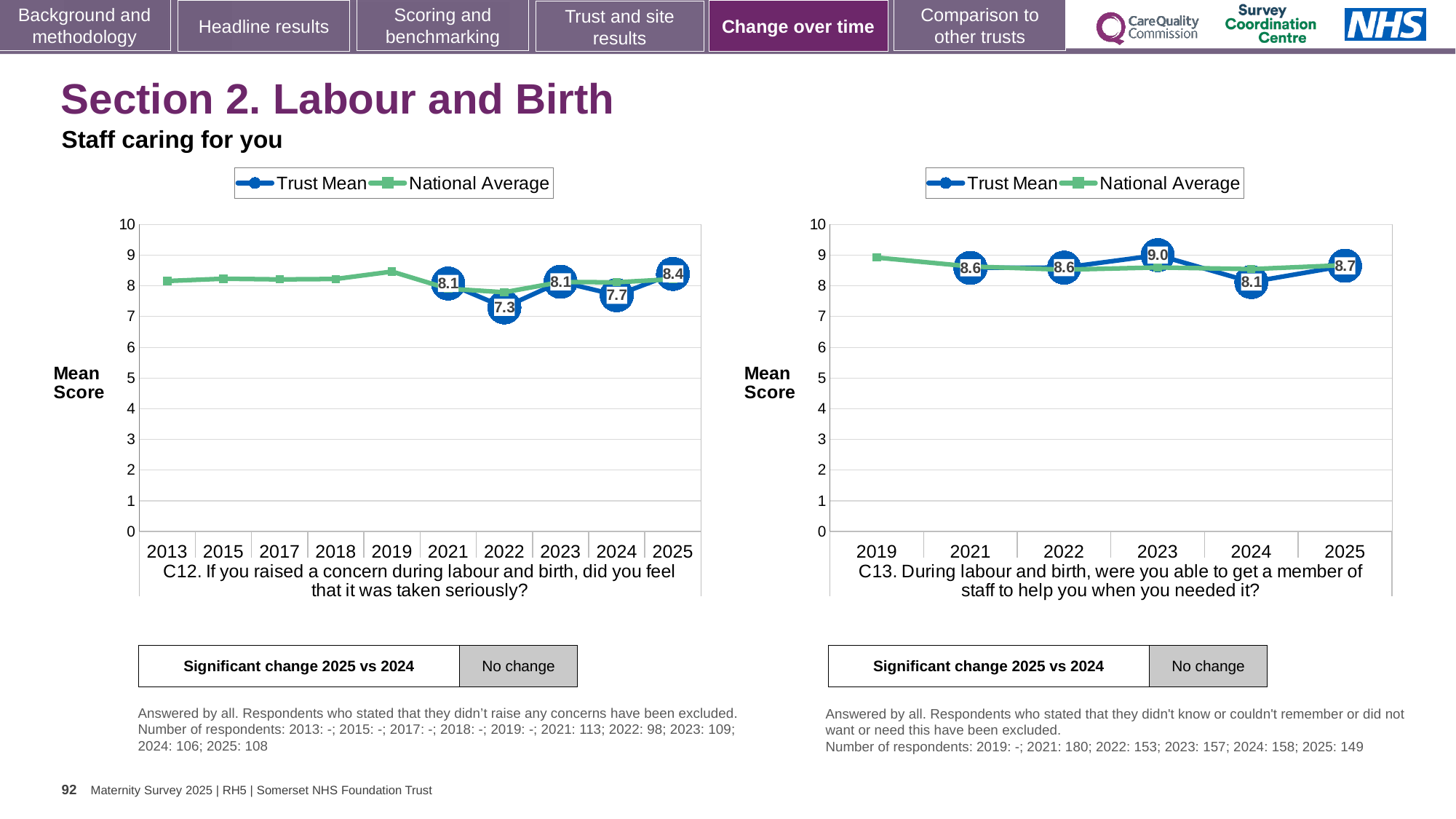
In the left chart (C12), is the National Average value for 2019 greater or less than 8? greater In the right chart (C13), what is the difference between the Trust Mean values for 2023 and 2024? 0.9 How many years are shown on the x axis of the left chart (C12)? 10 In the left chart (C12), what is the Trust Mean value for 2025? 8.4 In the right chart (C13), which year has the highest labelled Trust Mean value? 2023 In the left chart (C12), which year has the lowest labelled Trust Mean value? 2022 In the left chart (C12), what is the difference between the Trust Mean values for 2025 and 2024? 0.7 In the left chart (C12), what is the Trust Mean value for 2022? 7.3 In the right chart (C13), is the Trust Mean value for 2025 larger or smaller than the value for 2024? larger In the right chart (C13), what is the Trust Mean value for 2024? 8.1 In the right chart (C13), what is the Trust Mean value for 2023? 9.0 How many series does the legend of the right chart (C13) list? 2